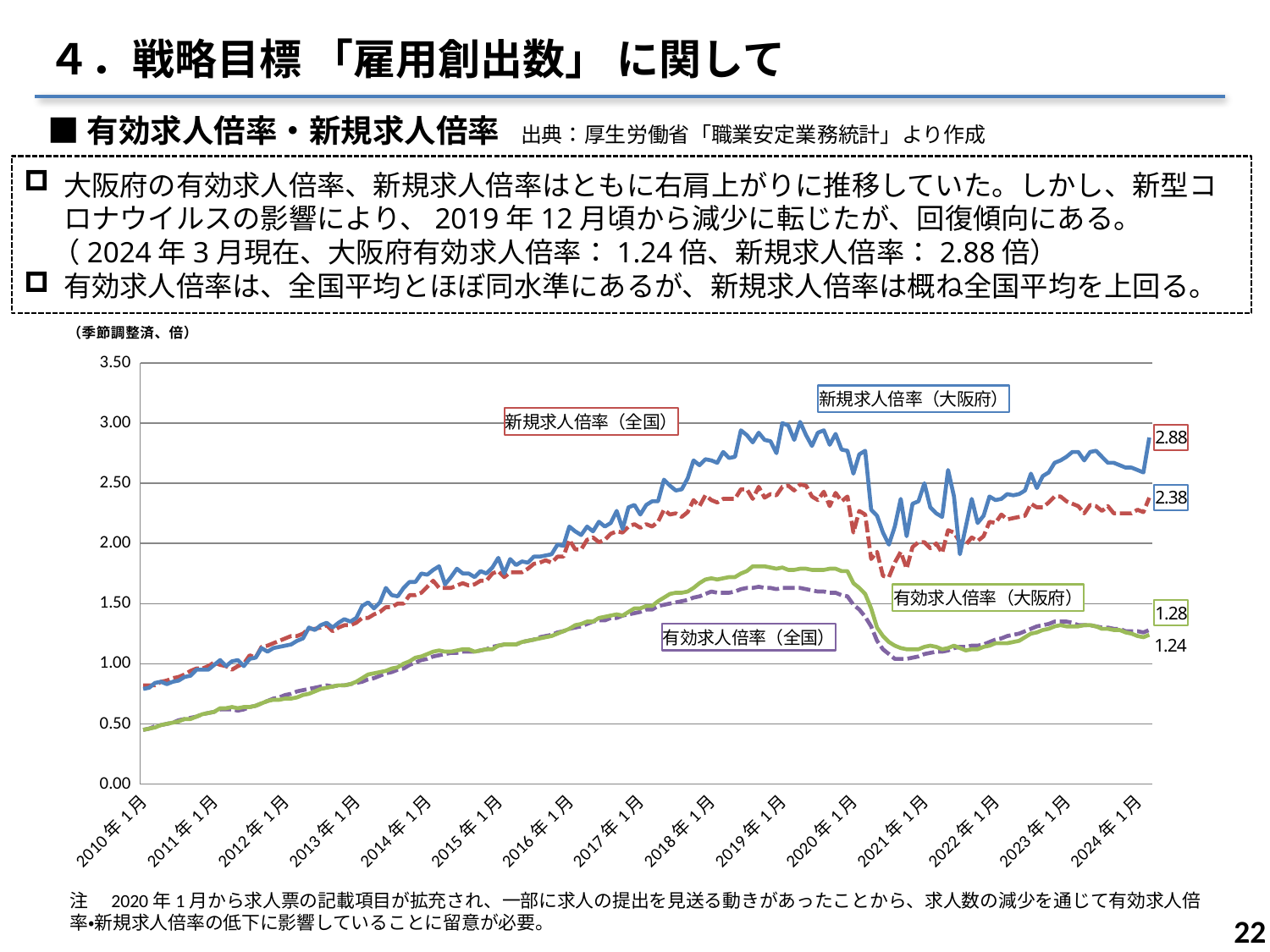
What is the maximum value shown on the vertical axis? 3.50 Does 新規求人倍率（大阪府） generally rise or fall from 2010年1月 to 2019年1月? rise Is the value for 有効求人倍率（大阪府） at 2010年1月 greater or less than 1.00? less What is the latest labelled value for 新規求人倍率（大阪府）? 2.88 What is the latest labelled value for 新規求人倍率（全国）? 2.38 How many data series are plotted on the chart? 4 What kind of chart is shown on the slide? line chart What is the latest value for 有効求人倍率（大阪府）? 1.24 Is the value for 新規求人倍率（大阪府） at 2010年1月 greater or less than 1.00? less At the right end of the chart, which is higher: 新規求人倍率（大阪府） or 新規求人倍率（全国）? 新規求人倍率（大阪府） What is the difference between the latest labelled values of 新規求人倍率（大阪府） and 新規求人倍率（全国）? 0.50 Is the peak value of 有効求人倍率（大阪府） around 2019 greater or less than 1.50? greater